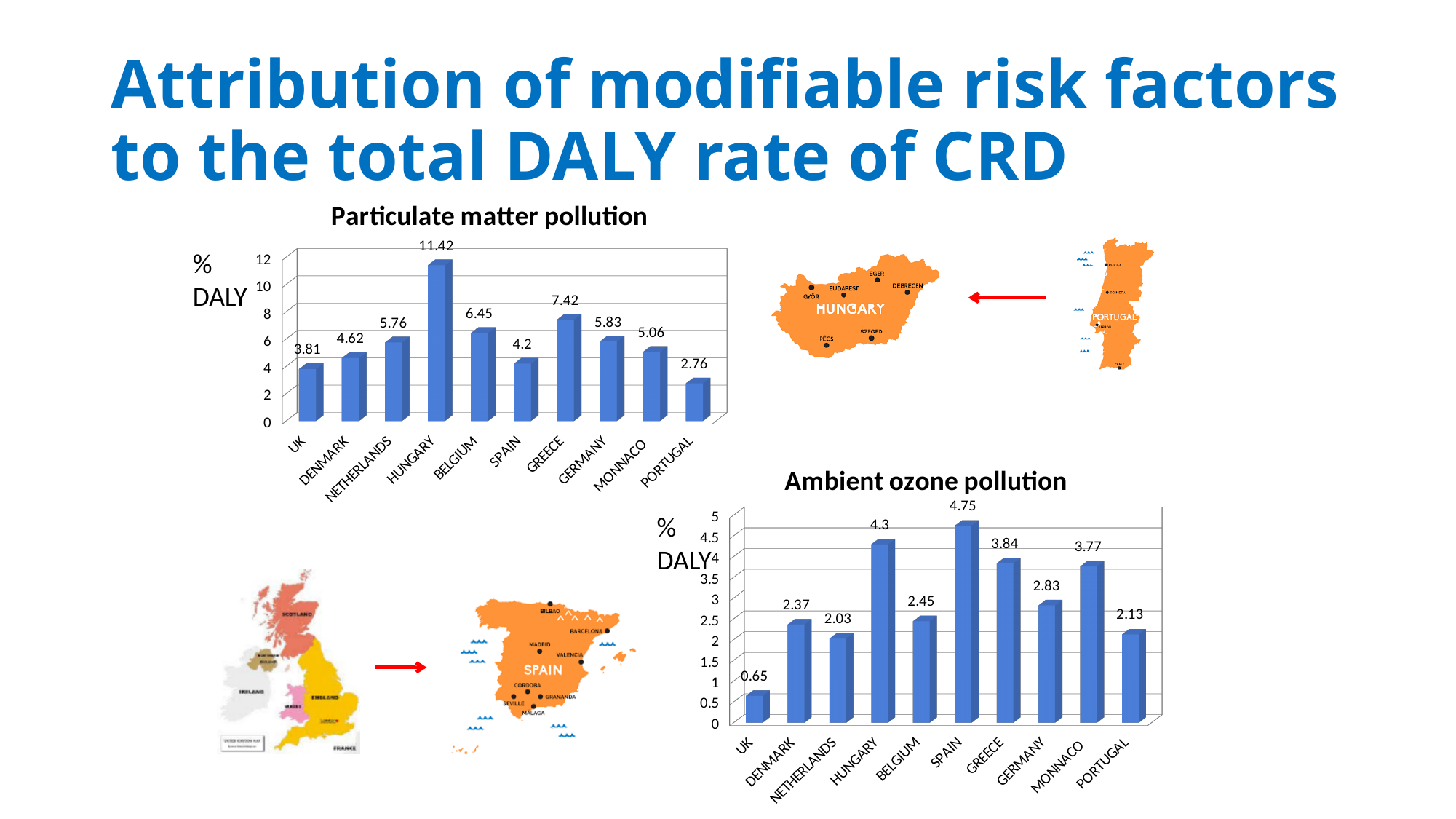
In the 'Ambient ozone pollution' chart, which is larger, the value for Denmark or the value for Netherlands? Denmark In the 'Particulate matter pollution' chart, which is larger, the value for Germany or the value for Netherlands? Germany In the 'Ambient ozone pollution' chart, which country has the lowest value? UK In the 'Ambient ozone pollution' chart, what is the difference between the values for Hungary and Belgium? 1.85 In the 'Particulate matter pollution' chart, what is the difference between the values for Greece and Spain? 3.22 What kind of chart is the 'Ambient ozone pollution' chart? Bar chart In the 'Particulate matter pollution' chart, which country has the lowest value? Portugal In the 'Particulate matter pollution' chart, how many countries are shown? 10 What is the y-axis label of the 'Particulate matter pollution' chart? % DALY In the 'Ambient ozone pollution' chart, what is the value for Spain? 4.75 In the 'Ambient ozone pollution' chart, what is the value for Monnaco? 3.77 In the 'Particulate matter pollution' chart, what is the value for Hungary? 11.42